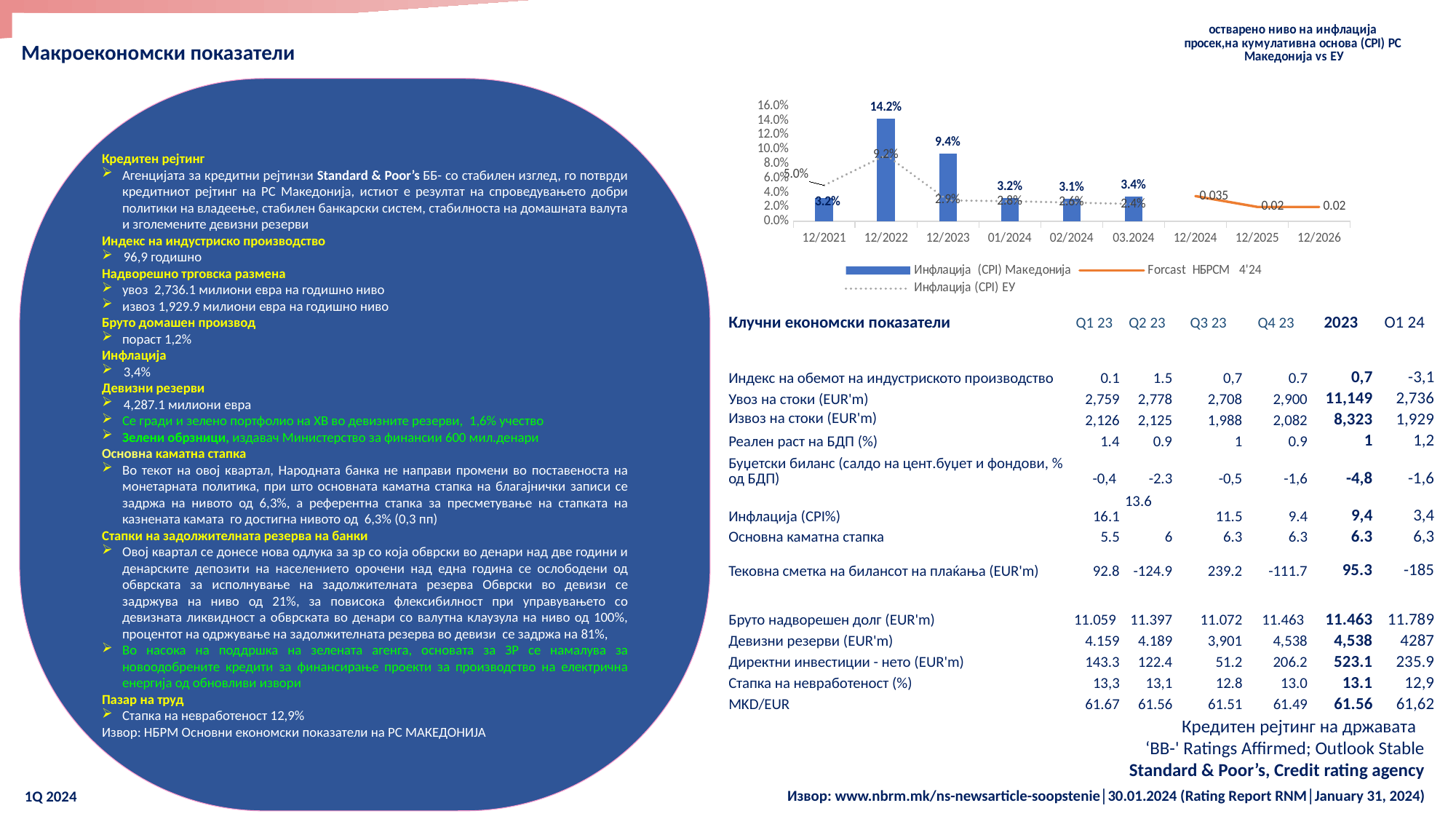
Which period has the highest Инфлација (CPI) Македонија bar? 12/2022 What is the Инфлација (CPI) ЕУ value for 12/2022? 9.2% Is the Инфлација (CPI) Македонија value for 12/2022 greater or less than 12.0%? greater How many series does the chart legend list? 3 What is the value of the Инфлација (CPI) Македонија bar for 12/2023? 9.4% What is the Forcast НБРСМ 4'24 value for 12/2024? 0.035 Do the Инфлација (CPI) Македонија bars rise or fall from 12/2022 to 02/2024? fall What is the difference between the Инфлација (CPI) Македонија values for 12/2022 and 12/2023? 4.8% Which is larger for 12/2023: Инфлација (CPI) Македонија or Инфлација (CPI) ЕУ? Инфлација (CPI) Македонија What is the value of the Инфлација (CPI) Македонија bar for 12/2022? 14.2% What is the value of the Инфлација (CPI) Македонија bar for 03.2024? 3.4% How many periods are shown on the x axis of the chart? 9